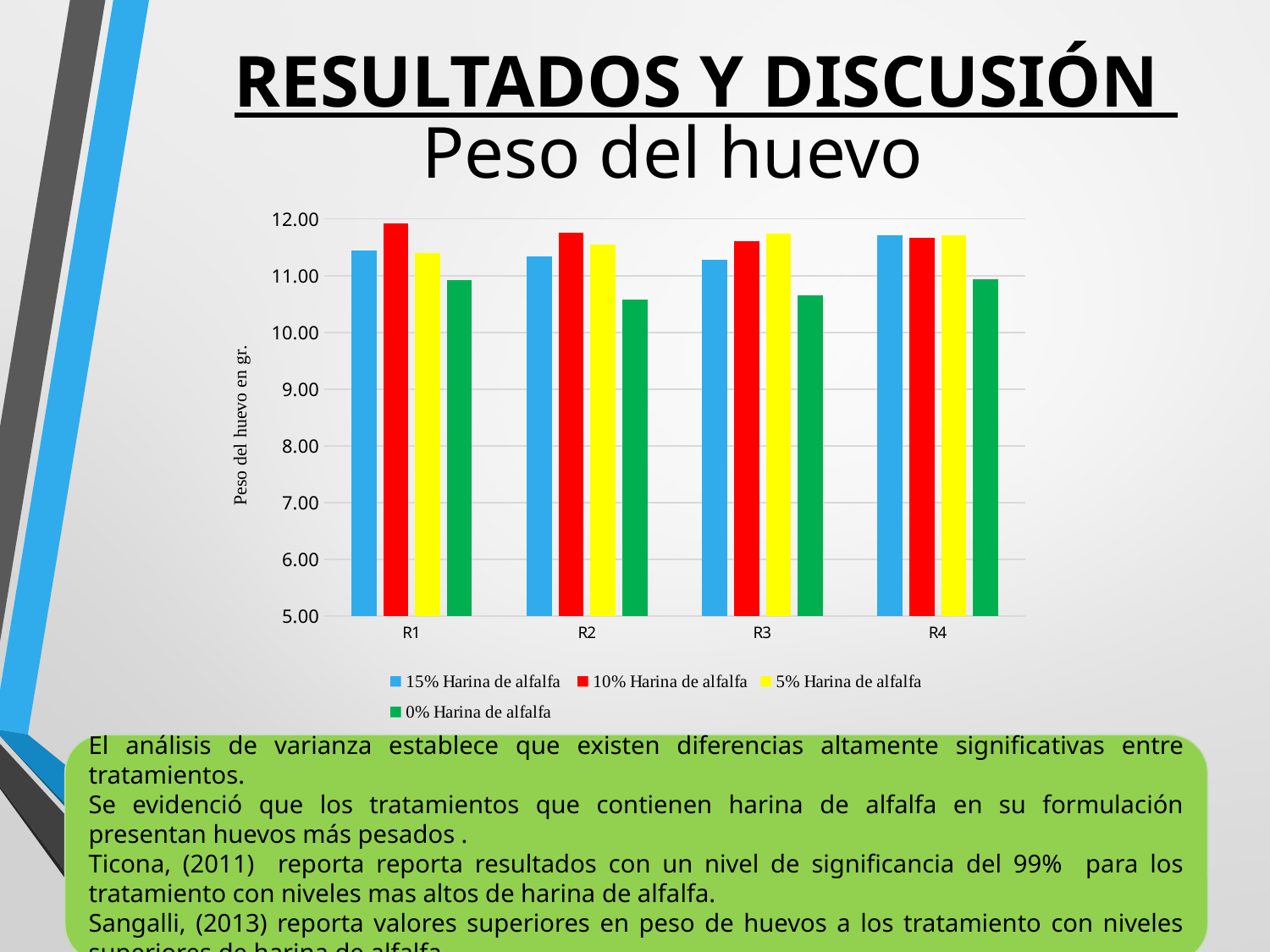
Is the value for '0% Harina de alfalfa' at R2 greater or less than 11.00? less Is the value for '10% Harina de alfalfa' at R1 greater or less than 11.00? greater Is the value for '0% Harina de alfalfa' at R3 greater or less than 11.00? less How many categories are shown on the x axis of the chart? 4 What is the title of the chart's vertical axis? Peso del huevo en gr. What kind of chart is shown on the slide? bar chart How many series does the chart's legend list? 4 Which series has the lowest value at R2? 0% Harina de alfalfa Which colour represents the series '0% Harina de alfalfa' in the chart? green At R2, which is larger: the value for '10% Harina de alfalfa' or the value for '0% Harina de alfalfa'? 10% Harina de alfalfa Which series has the highest value at R1? 10% Harina de alfalfa